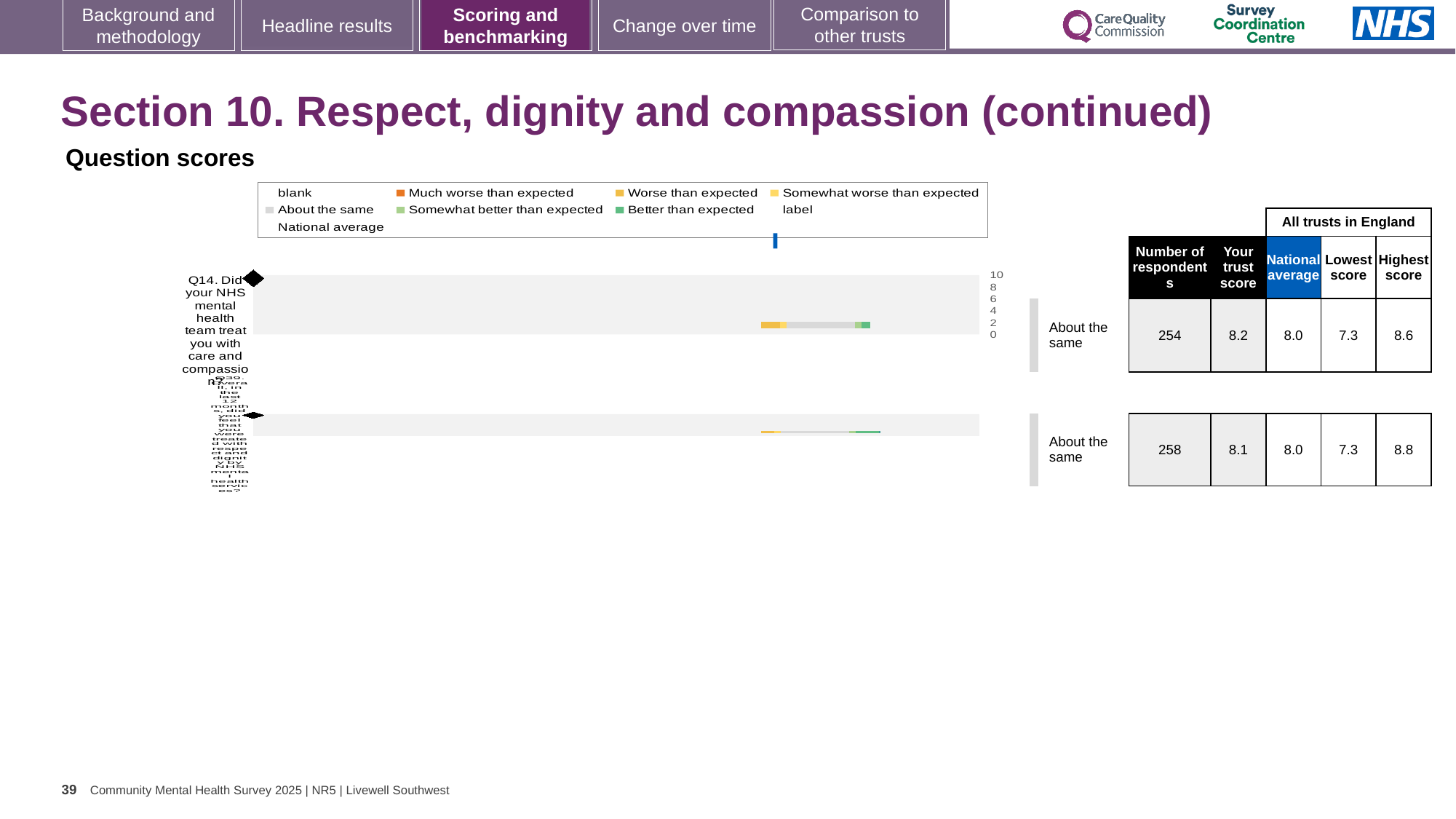
For Q14, which is larger: your trust score or the national average? Your trust score How many questions are plotted in the 'Question scores' chart? 2 In the table, what is the national average for Q14 (the first row)? 8.0 In the table, what is 'Your trust score' for Q14 (the first row)? 8.2 In the table, how many respondents are listed for Q14 (the first row)? 254 In the table, what is the highest score for the second row? 8.8 Which row of the table has the larger number of respondents, the first (Q14) or the second? the second In the chart legend, what colour represents 'Better than expected'? green What kind of chart is shown under 'Question scores'? bar chart What is the difference in number of respondents between the second row (258) and the first row (254)? 4 What benchmark category is shown next to the Q14 bar? About the same For Q14, what is the difference between the highest score and the lowest score in the table? 1.3